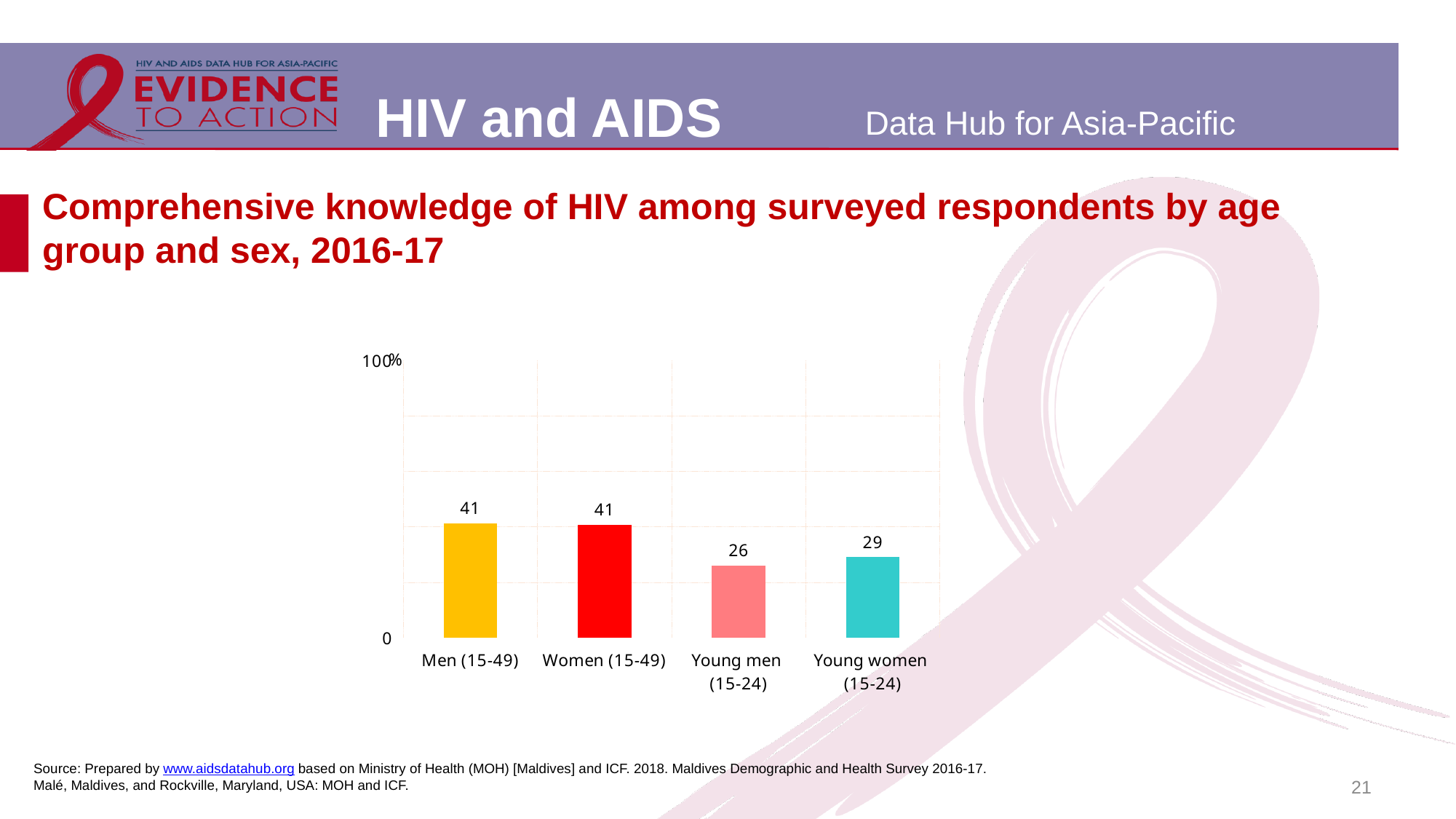
What kind of chart is shown on the slide? Bar chart What is the value for Young women (15-24)? 29 What is the value for Men (15-49)? 41 What is the difference between the values for Young women (15-24) and Young men (15-24)? 3 Which is larger, the value for Young women (15-24) or the value for Young men (15-24)? Young women (15-24) What is the value for Women (15-49)? 41 How many categories are shown on the x axis? 4 Which category has the lowest value? Young men (15-24) What is the difference between the values for Men (15-49) and Young men (15-24)? 15 What is the value for Young men (15-24)? 26 Which is larger, the value for Women (15-49) or the value for Young women (15-24)? Women (15-49) What is the title of the chart on the slide? Comprehensive knowledge of HIV among surveyed respondents by age group and sex, 2016-17